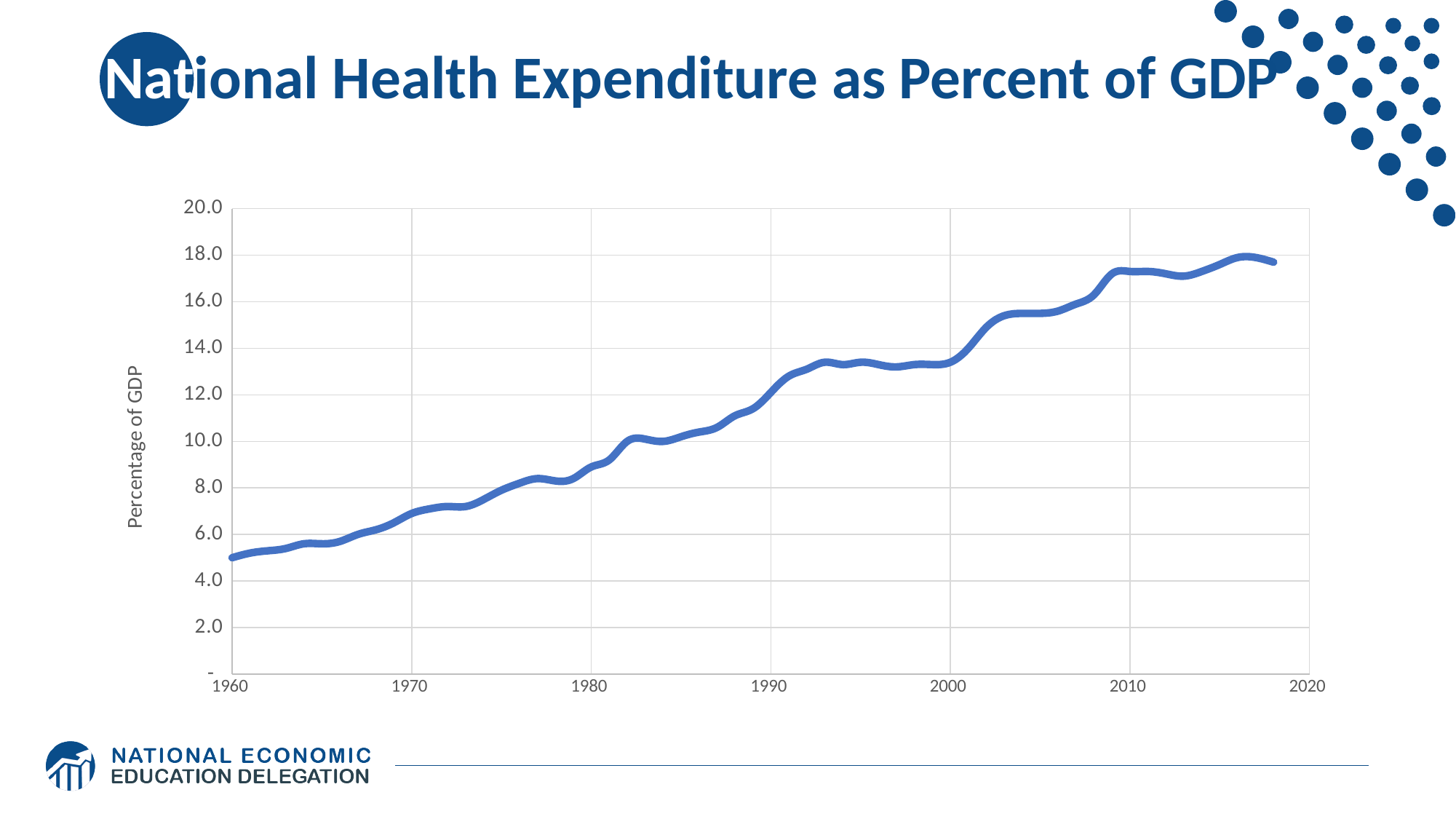
What is the title of the chart? National Health Expenditure as Percent of GDP Is the value for 2000 greater or less than 14.0? less Which year has the larger value, 1980 or 1990? 1990 Is the value for 1990 greater or less than 10.0? greater What kind of chart is shown on the slide? line chart Is the value for 2010 greater or less than 16.0? greater What is the label on the vertical axis? Percentage of GDP Which year has the larger value, 2000 or 2010? 2010 Overall, does the value rise or fall from 1960 to 2020? rise